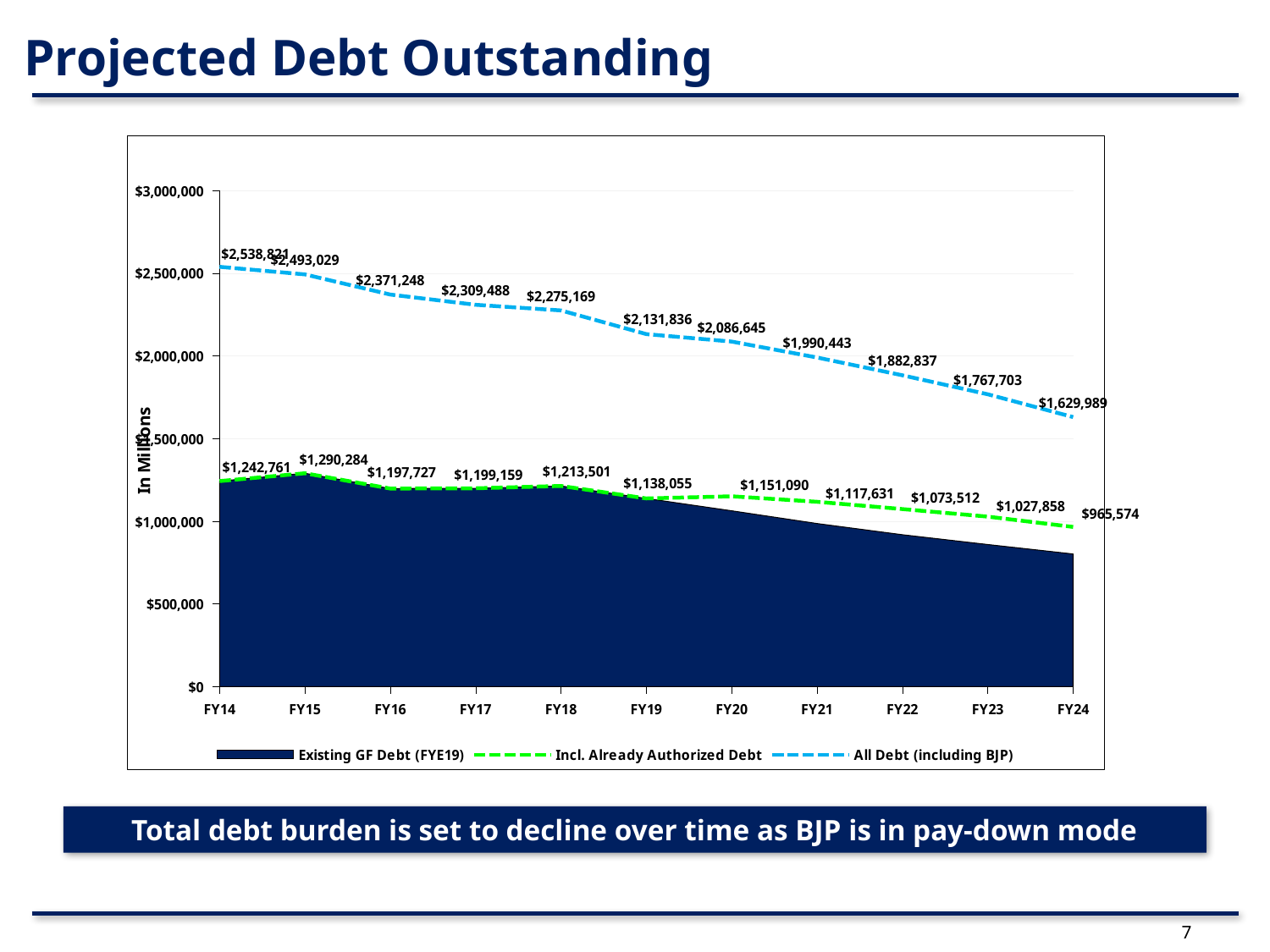
Is the value of Existing GF Debt (FYE19) in FY24 greater or less than $1,000,000? less What is the value of All Debt (including BJP) in FY14? $2,538,821 Which is larger for Incl. Already Authorized Debt: FY18 or FY20? FY18 In which fiscal year is Incl. Already Authorized Debt highest? FY15 In which fiscal year is All Debt (including BJP) lowest? FY24 How many series does the legend list? 3 By how much does All Debt (including BJP) decline from FY14 to FY24? $908,832 What is the value of All Debt (including BJP) in FY24? $1,629,989 What is the value of Incl. Already Authorized Debt in FY19? $1,138,055 How many fiscal years are shown on the x axis? 11 What is the value of Incl. Already Authorized Debt in FY24? $965,574 What is the overall trend of All Debt (including BJP) from FY14 to FY24? Falling